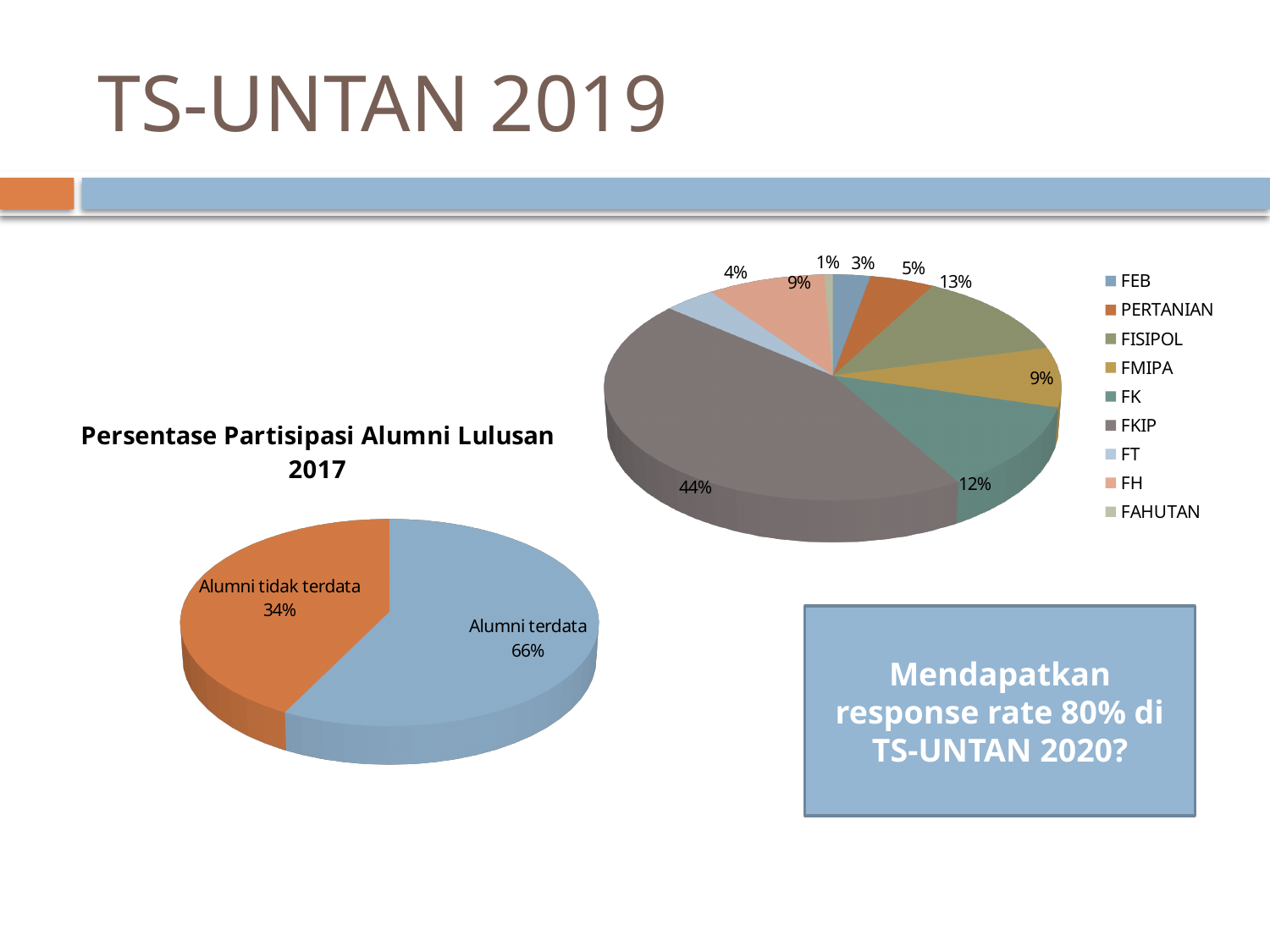
In the chart titled 'Persentase Partisipasi Alumni Lulusan 2017', what is the difference between the Alumni terdata and Alumni tidak terdata shares? 32% In the pie chart on the right of the slide, which faculty has the smallest share? FAHUTAN In the chart titled 'Persentase Partisipasi Alumni Lulusan 2017', what is the share for Alumni tidak terdata? 34% In the pie chart on the right of the slide, what is the share for FKIP? 44% In the pie chart on the right of the slide, which faculty has the largest share? FKIP In the pie chart on the right of the slide, what is the difference between the FKIP share and the FK share? 32% In the pie chart on the right of the slide, which is larger, the share for PERTANIAN or the share for FT? PERTANIAN What kind of chart is the chart titled 'Persentase Partisipasi Alumni Lulusan 2017'? Pie chart In the pie chart on the right of the slide, how many categories does the legend list? 9 In the chart titled 'Persentase Partisipasi Alumni Lulusan 2017', what is the share for Alumni terdata? 66% In the pie chart on the right of the slide, what is the share for FK? 12% In the pie chart on the right of the slide, what is the share for FISIPOL? 13%